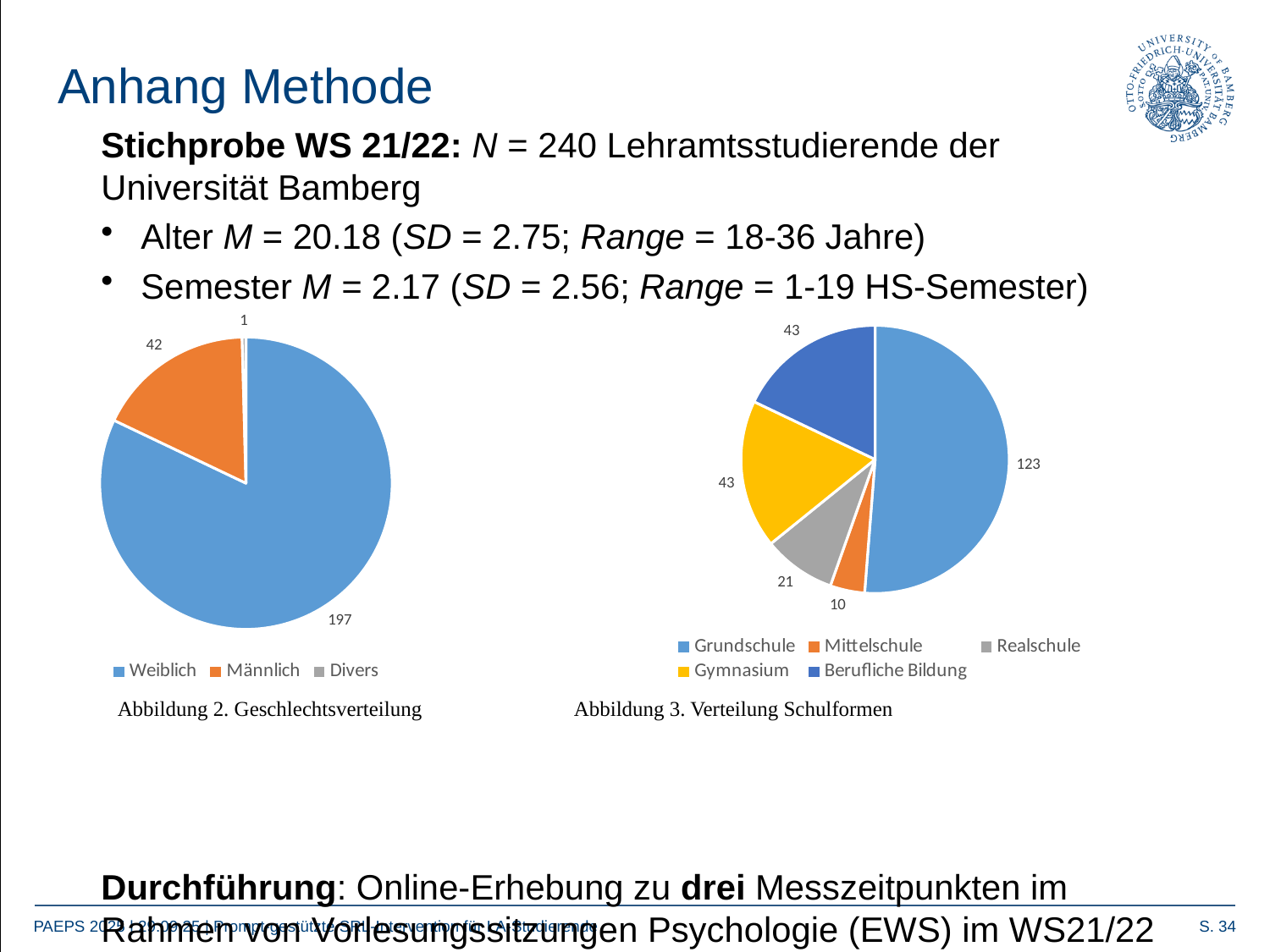
In the right pie chart (Abbildung 3. Verteilung Schulformen), what is the value for Realschule? 21 In the left pie chart (Abbildung 2. Geschlechtsverteilung), what is the value for Weiblich? 197 In the right pie chart (Abbildung 3. Verteilung Schulformen), which category has the largest value? Grundschule In the right pie chart (Abbildung 3. Verteilung Schulformen), which category has the smallest value? Mittelschule In the left pie chart (Abbildung 2. Geschlechtsverteilung), what is the difference between the values for Weiblich and Männlich? 155 In the left pie chart (Abbildung 2. Geschlechtsverteilung), which category has the smallest value? Divers In the right pie chart (Abbildung 3. Verteilung Schulformen), which is larger, the value for Realschule or the value for Mittelschule? Realschule In the right pie chart (Abbildung 3. Verteilung Schulformen), what is the value for Grundschule? 123 In the right pie chart (Abbildung 3. Verteilung Schulformen), what share of the total does Grundschule represent? 51.25% In the left pie chart (Abbildung 2. Geschlechtsverteilung), how many categories does the legend list? 3 In the left pie chart (Abbildung 2. Geschlechtsverteilung), what is the value for Männlich? 42 What type of chart is used for Abbildung 3. Verteilung Schulformen? Pie chart